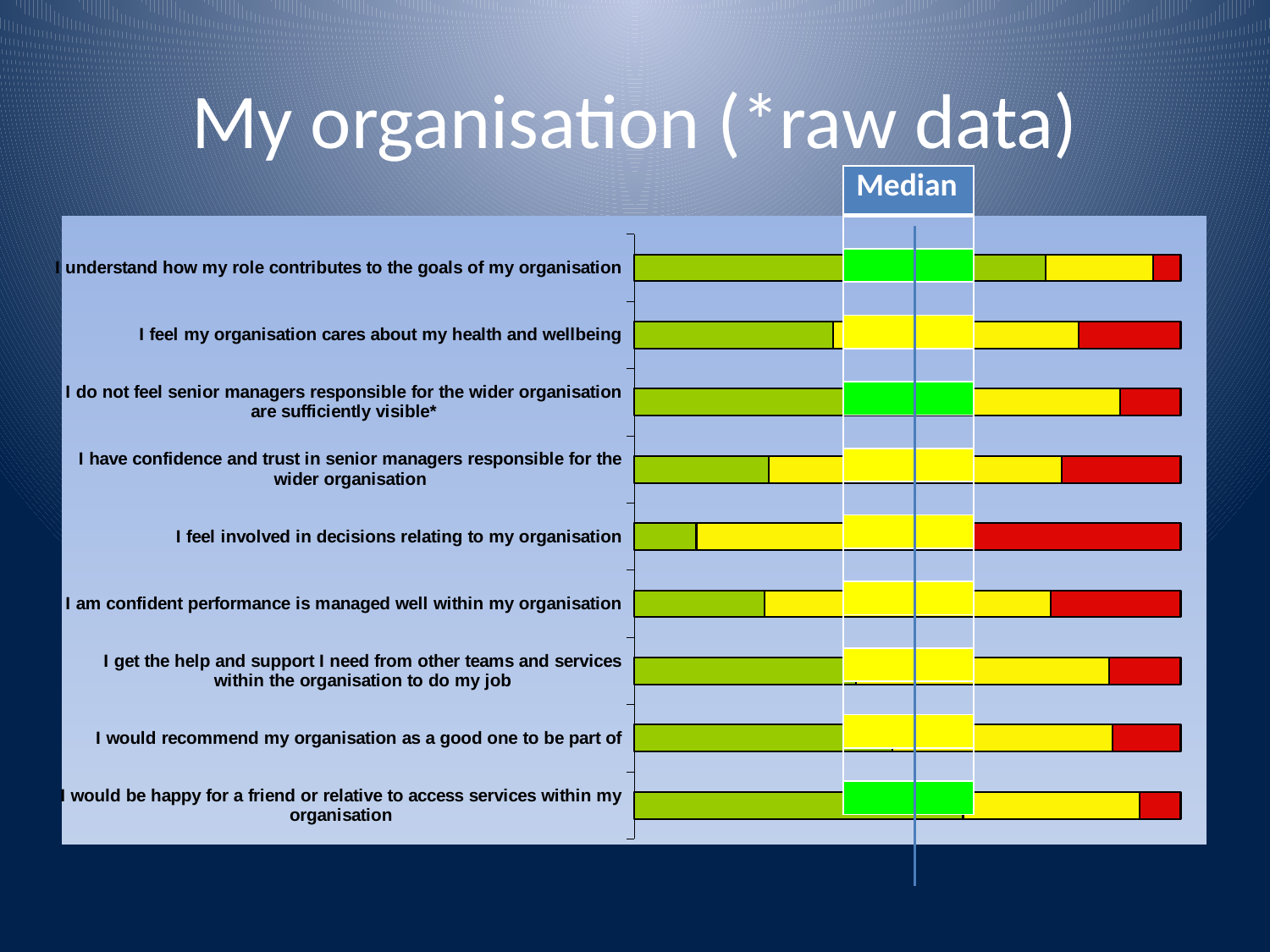
Which statement has the largest green segment in its bar? I understand how my role contributes to the goals of my organisation What is the label of the highlighted column overlaid on the chart? Median What is the title of the slide containing the chart? My organisation (*raw data) Which statement has the smallest green segment in its bar? I feel involved in decisions relating to my organisation Which has the larger green segment: "I feel my organisation cares about my health and wellbeing" or "I feel involved in decisions relating to my organisation"? I feel my organisation cares about my health and wellbeing Which statement has the largest red segment in its bar? I feel involved in decisions relating to my organisation Which has the larger red segment: "I would be happy for a friend or relative to access services within my organisation" or "I have confidence and trust in senior managers responsible for the wider organisation"? I have confidence and trust in senior managers responsible for the wider organisation How many statements have a green cell in the Median column? 3 How many statements (categories) are plotted in the chart? 9 What kind of chart is shown on the slide? Bar chart Which has the larger red segment: "I feel involved in decisions relating to my organisation" or "I understand how my role contributes to the goals of my organisation"? I feel involved in decisions relating to my organisation